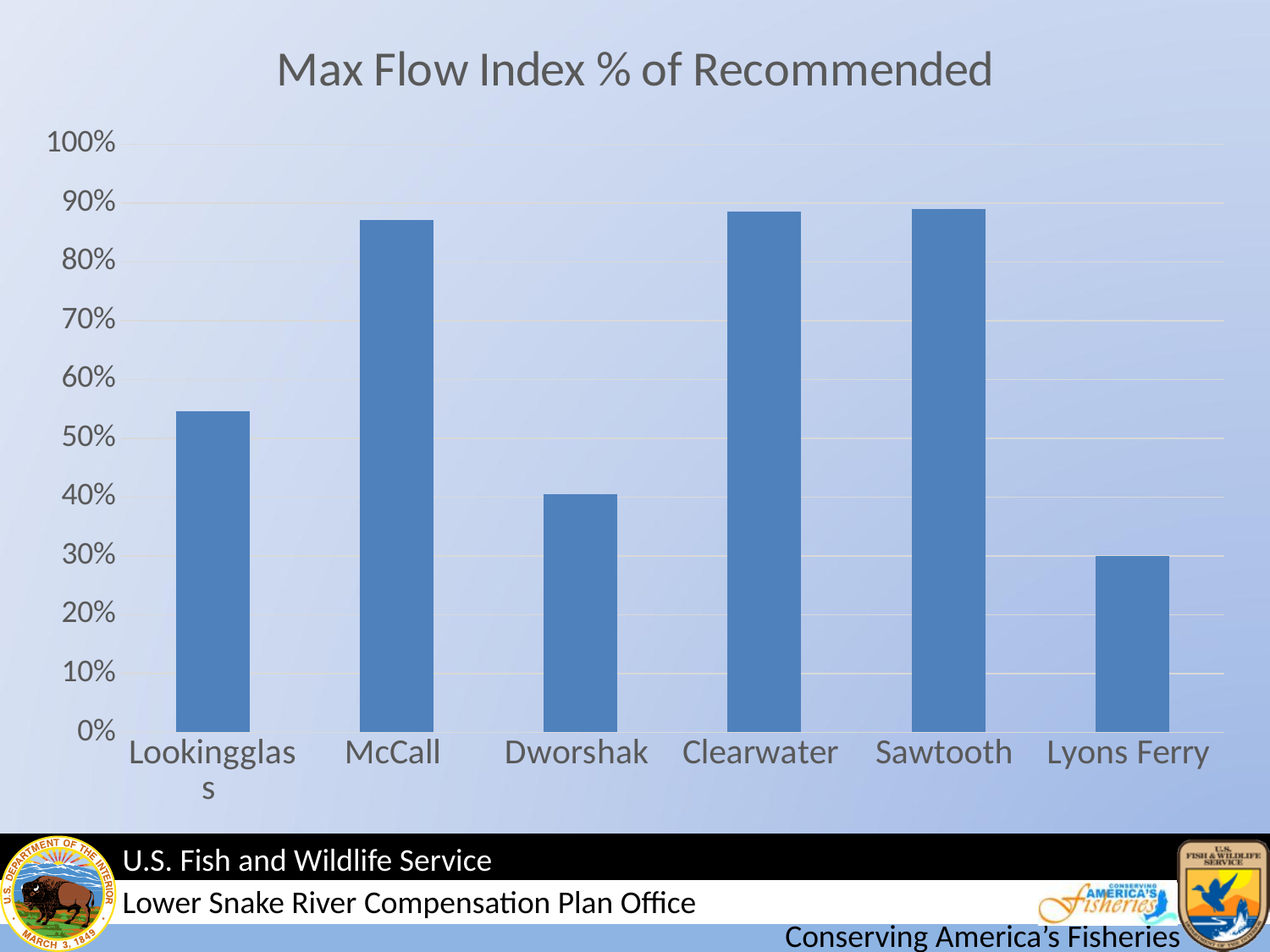
What is the title of the chart? Max Flow Index % of Recommended Is the value for Dworshak greater or less than 50%? less Is the value for Lookingglass greater or less than 50%? greater Is the value for McCall greater or less than 80%? greater What kind of chart is shown on the slide? bar chart Which is larger, the value for Dworshak or the value for Lyons Ferry? Dworshak Which is larger, the value for McCall or the value for Lookingglass? McCall How many categories are plotted on the x axis? 6 Which is larger, the value for Clearwater or the value for Dworshak? Clearwater Which category has the lowest value? Lyons Ferry